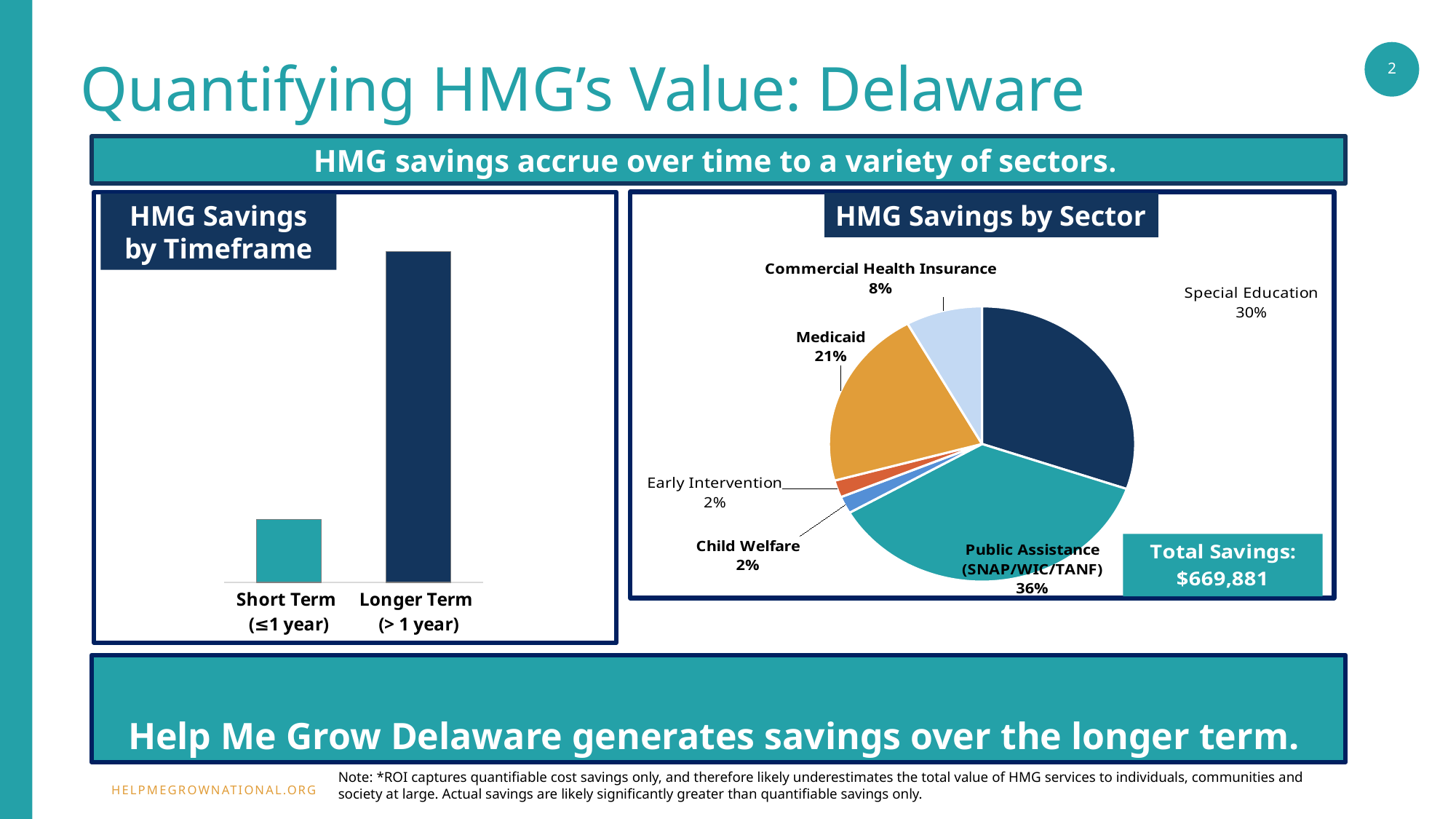
In the "HMG Savings by Sector" chart, what is the value for Commercial Health Insurance? 8% In the "HMG Savings by Sector" chart, what is the difference between the Public Assistance (SNAP/WIC/TANF) share and the Special Education share? 6% In the "HMG Savings by Timeframe" chart, which timeframe has the larger bar? Longer Term (> 1 year) What kind of chart is the "HMG Savings by Timeframe" chart? bar chart In the "HMG Savings by Sector" chart, what is the value for Medicaid? 21% What kind of chart is the "HMG Savings by Sector" chart? pie chart In the "HMG Savings by Sector" chart, what share of savings goes to Public Assistance (SNAP/WIC/TANF)? 36% In the "HMG Savings by Sector" chart, which sector has the largest share? Public Assistance (SNAP/WIC/TANF) How many sectors are shown in the "HMG Savings by Sector" pie chart? 6 In the "HMG Savings by Timeframe" chart, which category has the lowest value? Short Term (≤1 year) What total savings figure is shown on the "HMG Savings by Sector" chart? $669,881 How many categories are shown in the "HMG Savings by Timeframe" chart? 2